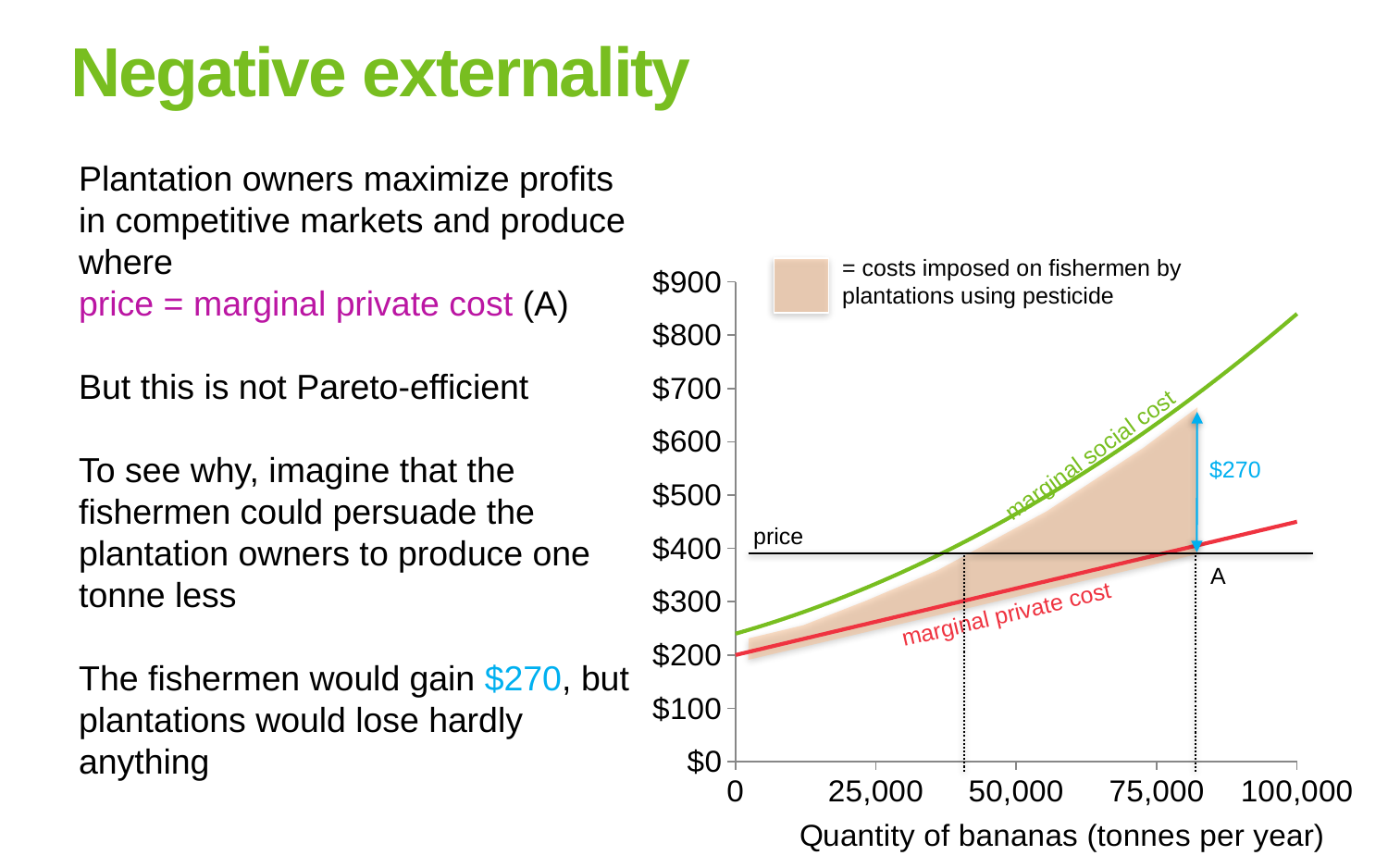
What does the shaded area on the chart represent? costs imposed on fishermen by plantations using pesticide Does the marginal private cost curve rise or fall as the quantity of bananas increases? rise Is the marginal private cost at 100,000 tonnes per year greater or less than $400? greater Which curve is the highest at 75,000 tonnes per year? marginal social cost What letter labels the point where the price line meets the marginal private cost curve? A Is the marginal social cost at 100,000 tonnes per year greater or less than $800? greater Is the marginal social cost at 0 tonnes per year greater or less than $300? less At 100,000 tonnes per year, which is higher: marginal social cost or marginal private cost? marginal social cost What is the value of the vertical gap between marginal social cost and marginal private cost marked at point A? $270 Does the marginal social cost curve rise or fall as the quantity of bananas increases? rise What kind of chart is shown on the slide? line chart